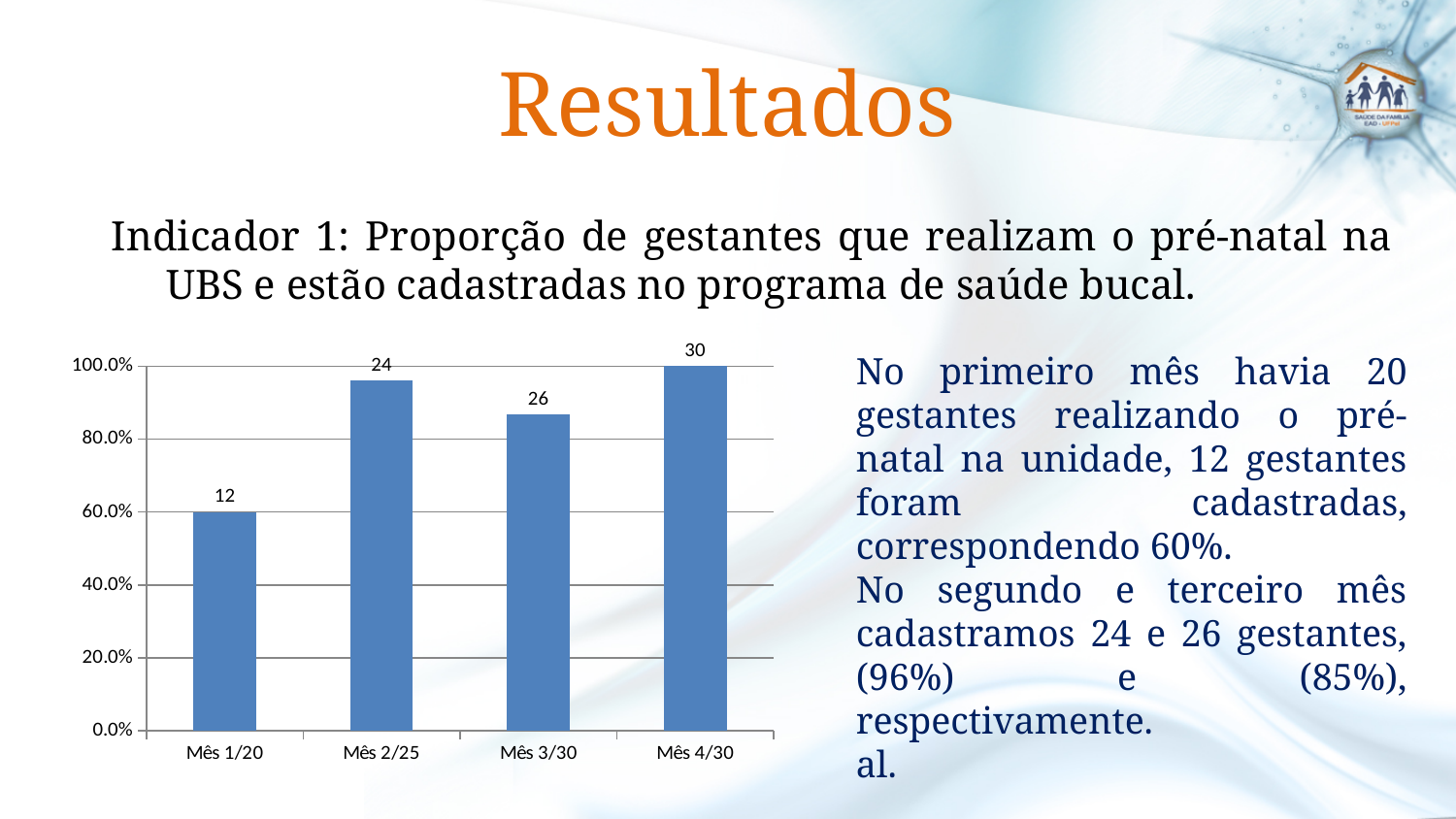
How many categories are shown on the x axis of the chart? 4 Which category has the tallest bar in the chart? Mês 4/30 What data label is shown on the bar for Mês 4/30? 30 What data label is shown on the bar for Mês 3/30? 26 Which category has the shortest bar in the chart? Mês 1/20 What data label is shown on the bar for Mês 2/25? 24 Which bar is taller, Mês 1/20 or Mês 4/30? Mês 4/30 What data label is shown on the bar for Mês 1/20? 12 Is the bar for Mês 1/20 greater or less than 80.0% on the vertical axis? less Is the bar for Mês 3/30 greater or less than 80.0% on the vertical axis? greater What is the difference between the data labels for Mês 4/30 and Mês 1/20? 18 What kind of chart is shown on the slide? bar chart